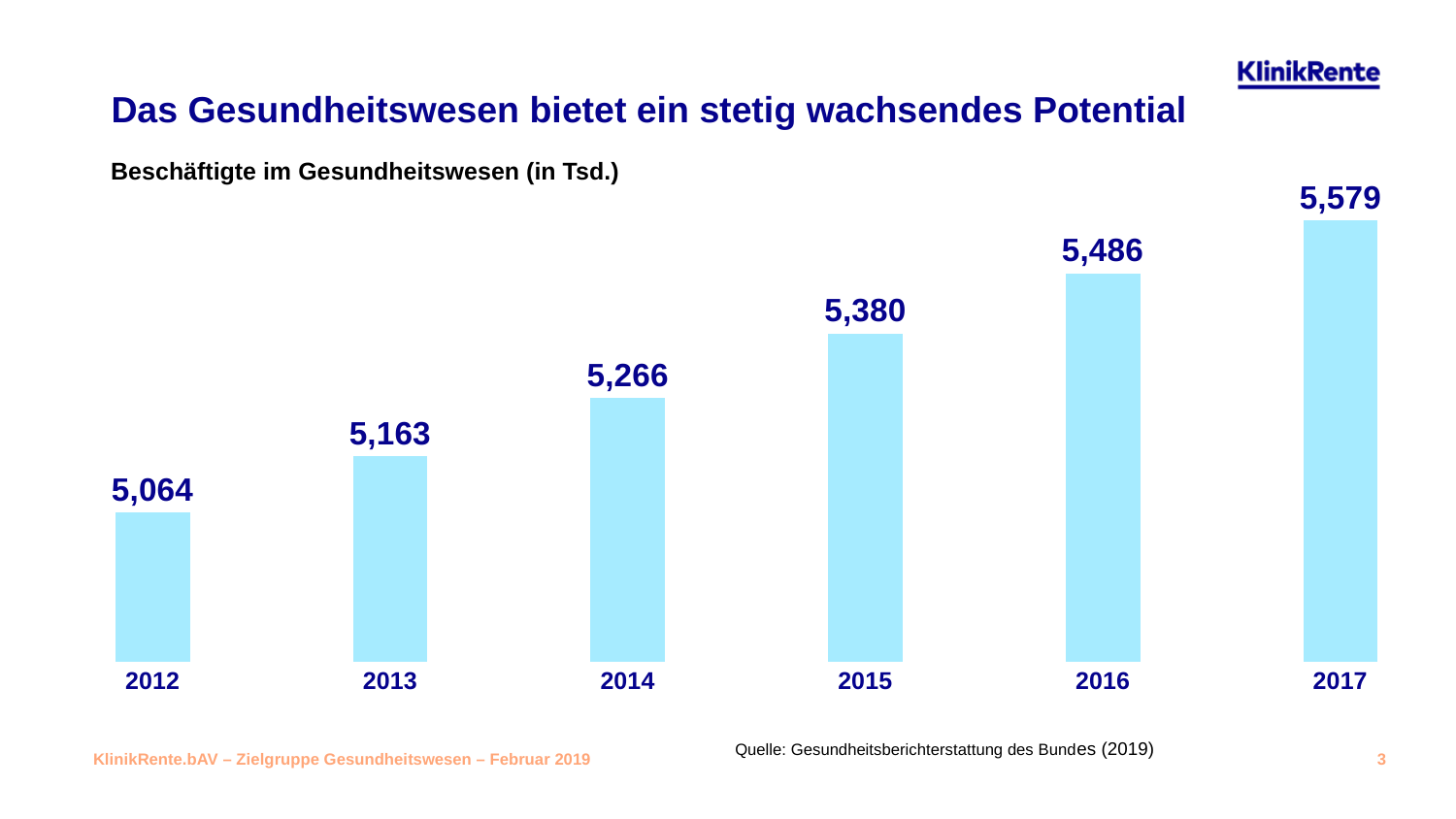
Which year has the lowest value? 2012 Do the values rise or fall from 2012 to 2017? rise What is the difference between the values for 2014 and 2013? 103 What is the value for 2012? 5,064 What is the title of the chart? Beschäftigte im Gesundheitswesen (in Tsd.) What kind of chart is shown on the slide? bar chart Which is larger, the value for 2016 or the value for 2014? 2016 How many years are shown on the chart? 6 Which year has the highest value? 2017 What is the difference between the values for 2017 and 2012? 515 What is the value for 2017? 5,579 What is the value for 2015? 5,380